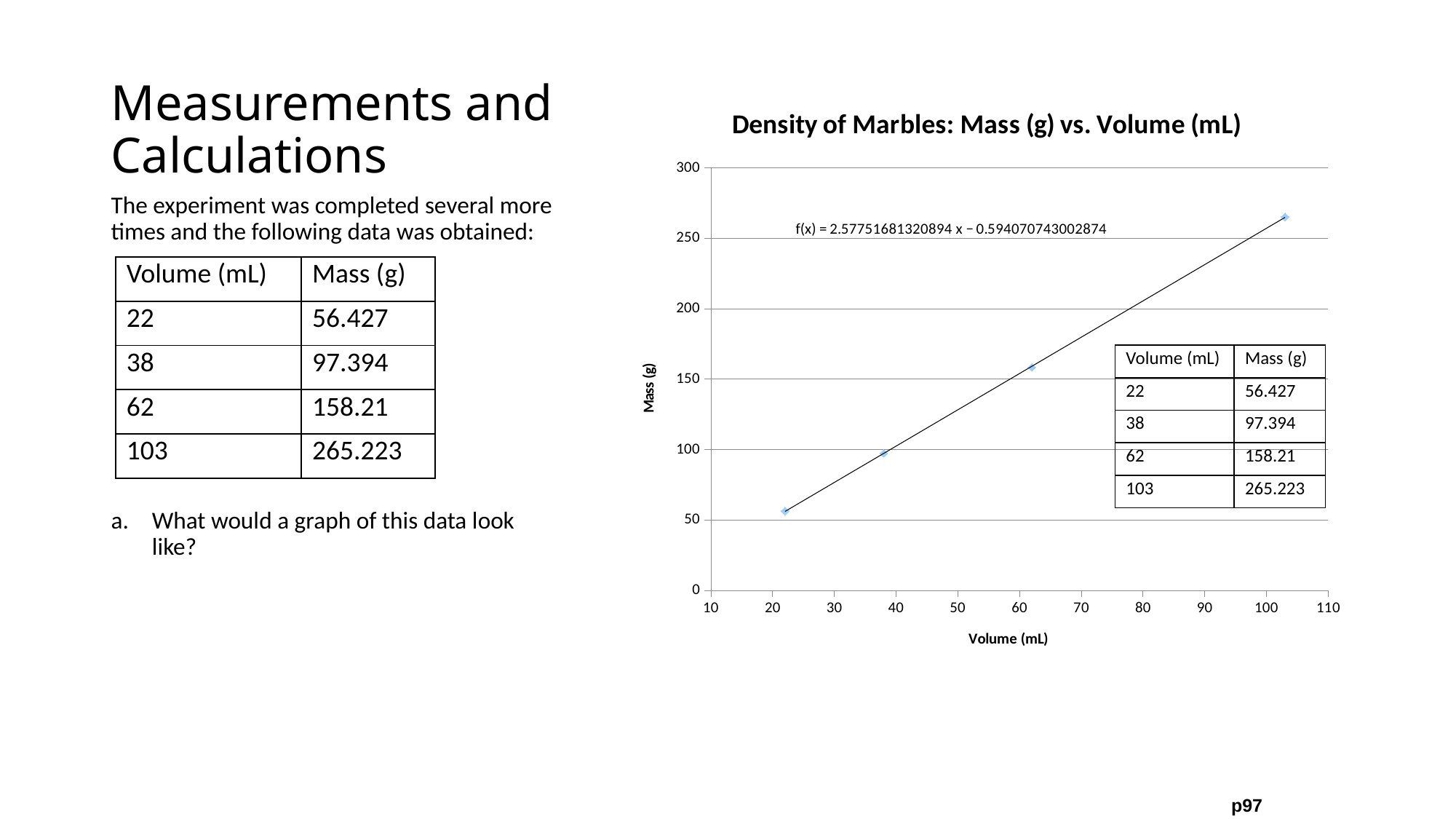
Do the mass values rise or fall as volume increases along the x axis? rise Which volume has the lowest mass on the chart? 22 mL Is the mass for 38 mL greater or less than 100? less What is the label on the y axis of the chart? Mass (g) How many data points are plotted on the chart? 4 What is the mass (g) plotted for a volume of 103 mL? 265.223 What is the difference in mass between the 103 mL point and the 22 mL point? 208.796 What is the title of the chart? Density of Marbles: Mass (g) vs. Volume (mL) Which volume has the highest mass on the chart? 103 mL What kind of chart is shown on the slide? scatter chart What is the mass (g) plotted for a volume of 62 mL? 158.21 What is the mass (g) plotted for a volume of 22 mL? 56.427